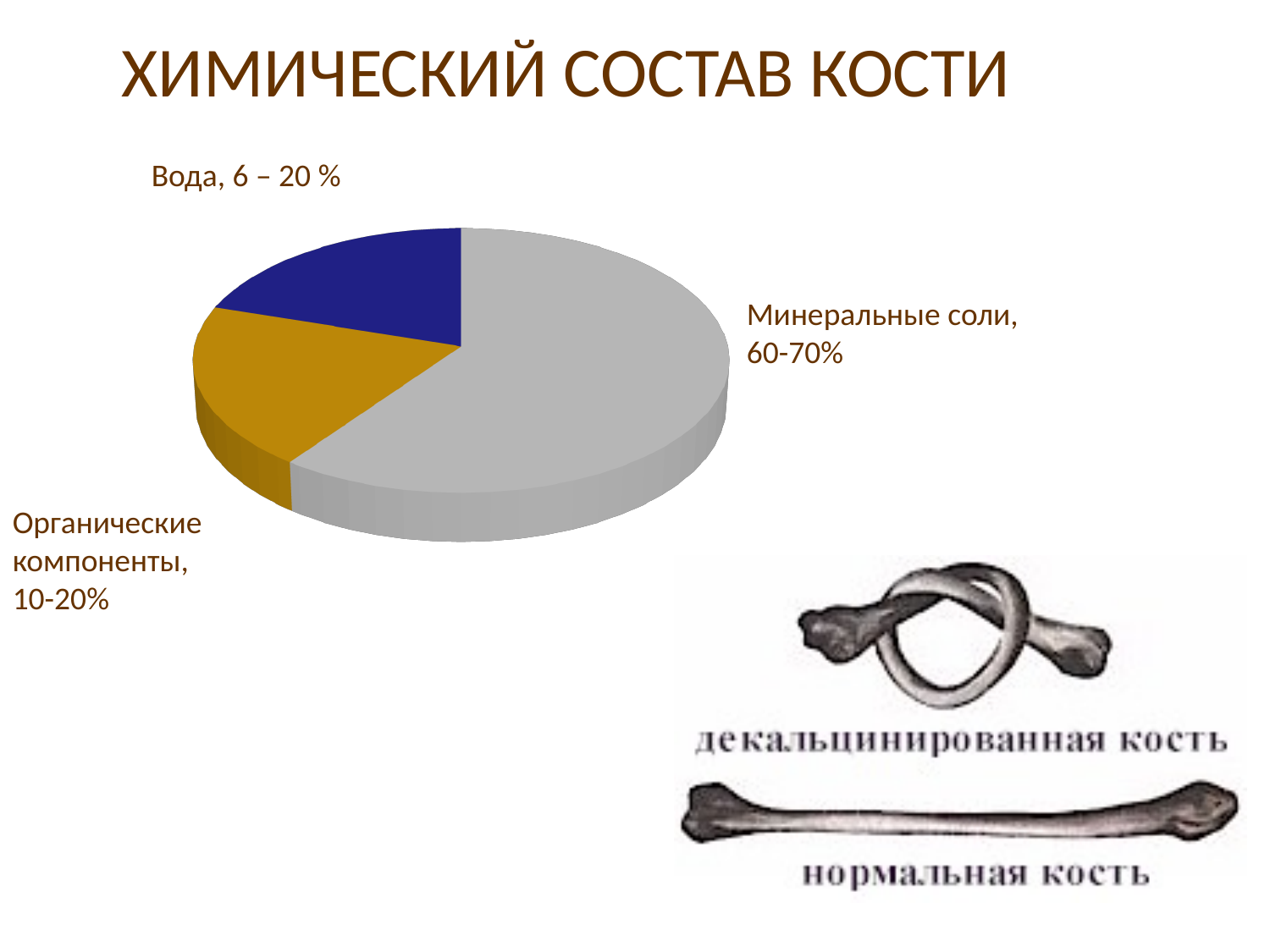
What share is shown for Минеральные соли in the pie chart? 60-70% How many slices does the pie chart have? 3 Which is larger in the pie chart, Минеральные соли or Вода? Минеральные соли What kind of chart is shown on the slide? pie chart What share is shown for Органические компоненты in the pie chart? 10-20% Which slice of the pie chart is the largest? Минеральные соли What is the title of the slide containing the pie chart? ХИМИЧЕСКИЙ СОСТАВ КОСТИ What share is shown for Вода in the pie chart? 6 – 20 % Which is larger in the pie chart, Минеральные соли or Органические компоненты? Минеральные соли Is the share for Минеральные соли greater or less than 50%? greater What colour is the Минеральные соли slice in the pie chart? grey